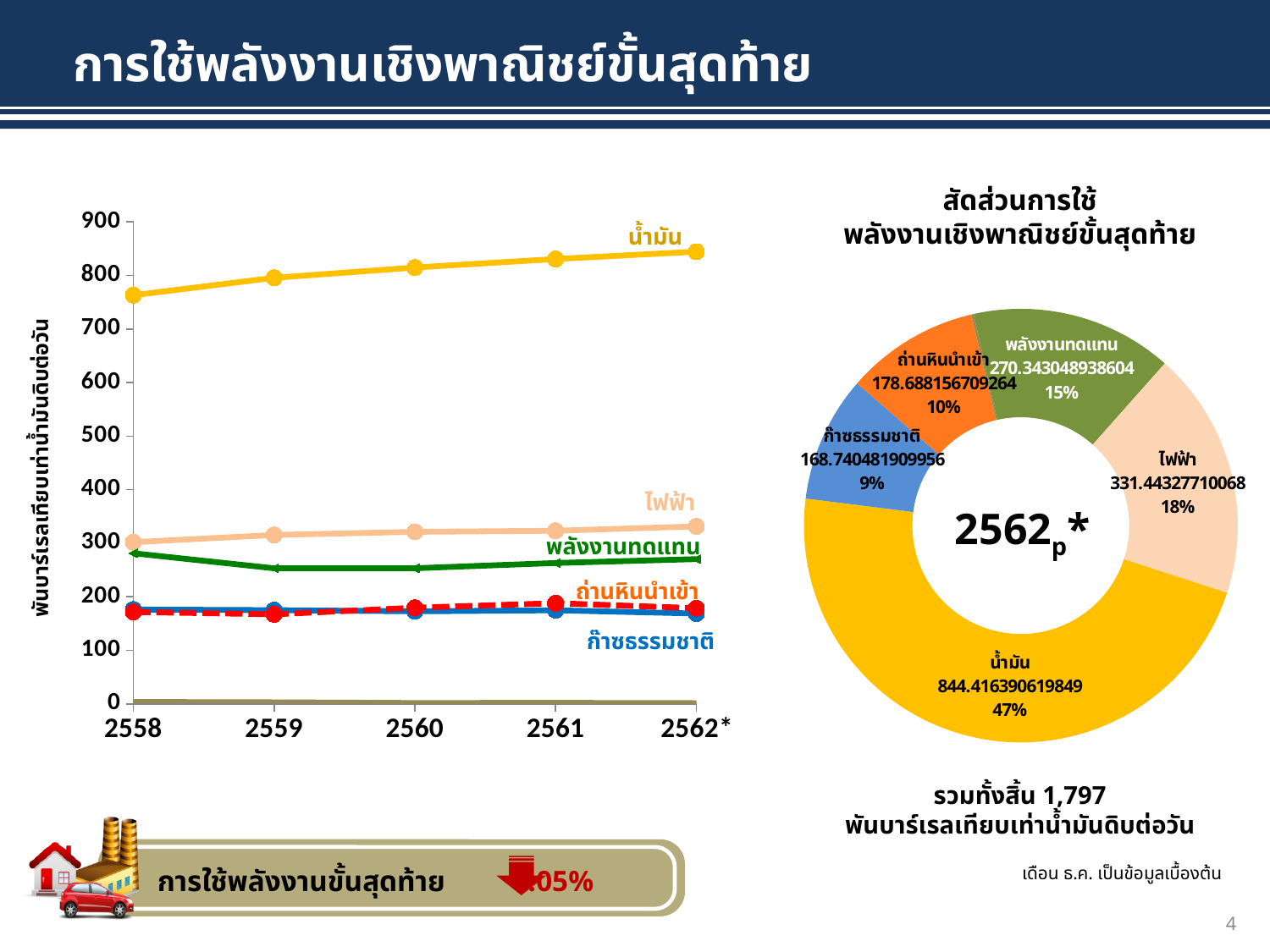
In the line chart on the left, how many years are shown on the x axis? 5 In the line chart on the left, which is higher in 2562*, พลังงานทดแทน or ถ่านหินนำเข้า? พลังงานทดแทน In the doughnut chart on the right, what value is shown for ก๊าซธรรมชาติ? 168.740481909956 In the doughnut chart on the right, what is the difference in percentage share between ถ่านหินนำเข้า and ก๊าซธรรมชาติ? 1% In the doughnut chart on the right, what value is shown for ไฟฟ้า? 331.44327710068 In the doughnut chart on the right, which category has the largest slice? น้ำมัน In the line chart on the left, does the น้ำมัน line rise or fall from 2558 to 2562*? Rises In the line chart on the left, is the value for น้ำมัน in 2558 greater or less than 800? less In the doughnut chart on the right, what share does น้ำมัน have? 47% What kind of chart is the chart on the left of the slide? Line chart